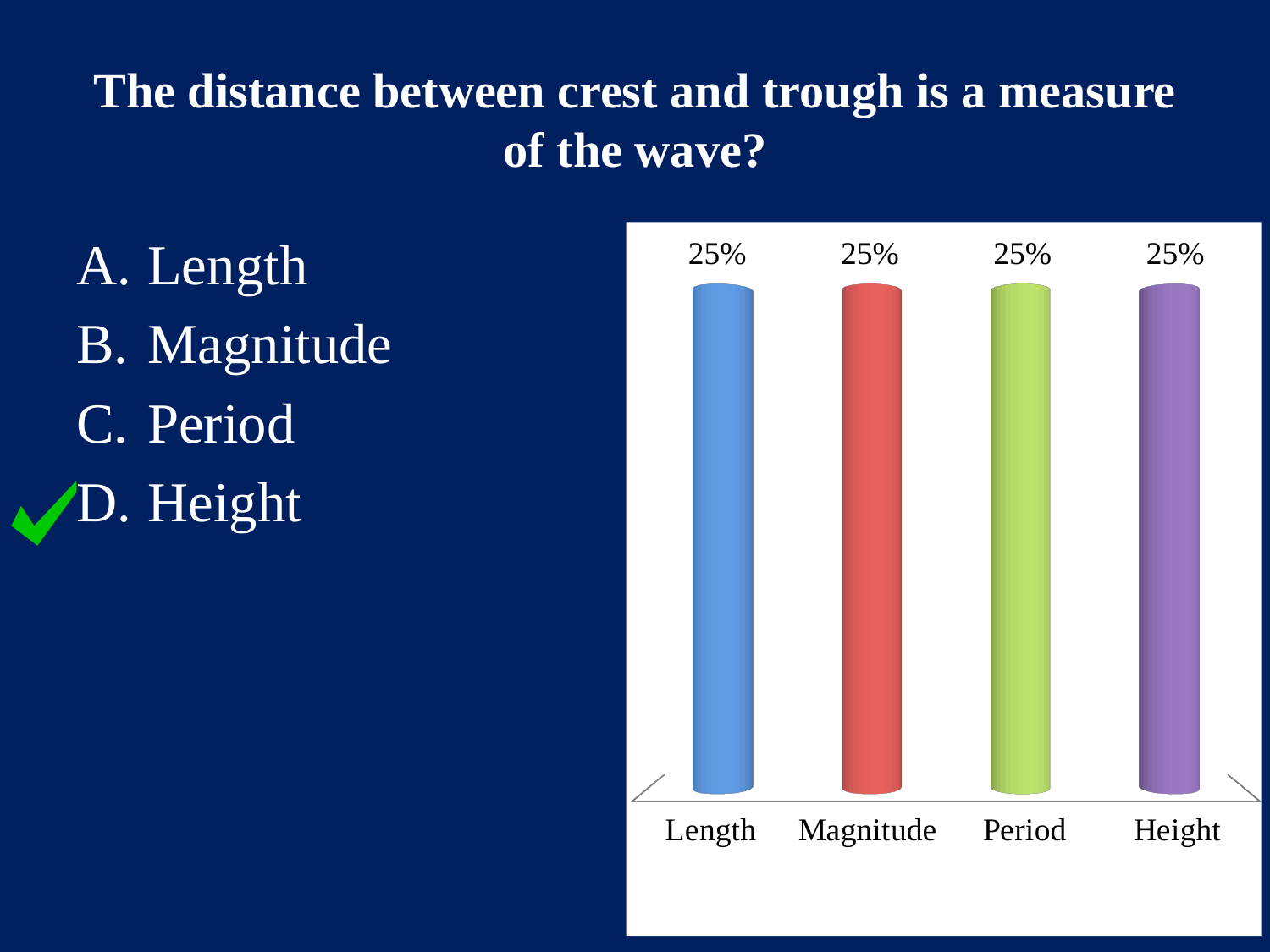
What is the value shown for Length? 25% What is the difference between the values for Length and Height? 0% What kind of chart is shown on the slide? bar chart What is the label of the first category on the x axis? Length What is the total of the four values shown on the chart? 100% What is the value shown for Magnitude? 25% What is the value shown for Height? 25% What colour is the bar for Magnitude? red What is the value shown for Period? 25% Do the values rise, fall, or stay the same across the categories from Length to Height? stay the same How many categories are plotted on the chart? 4